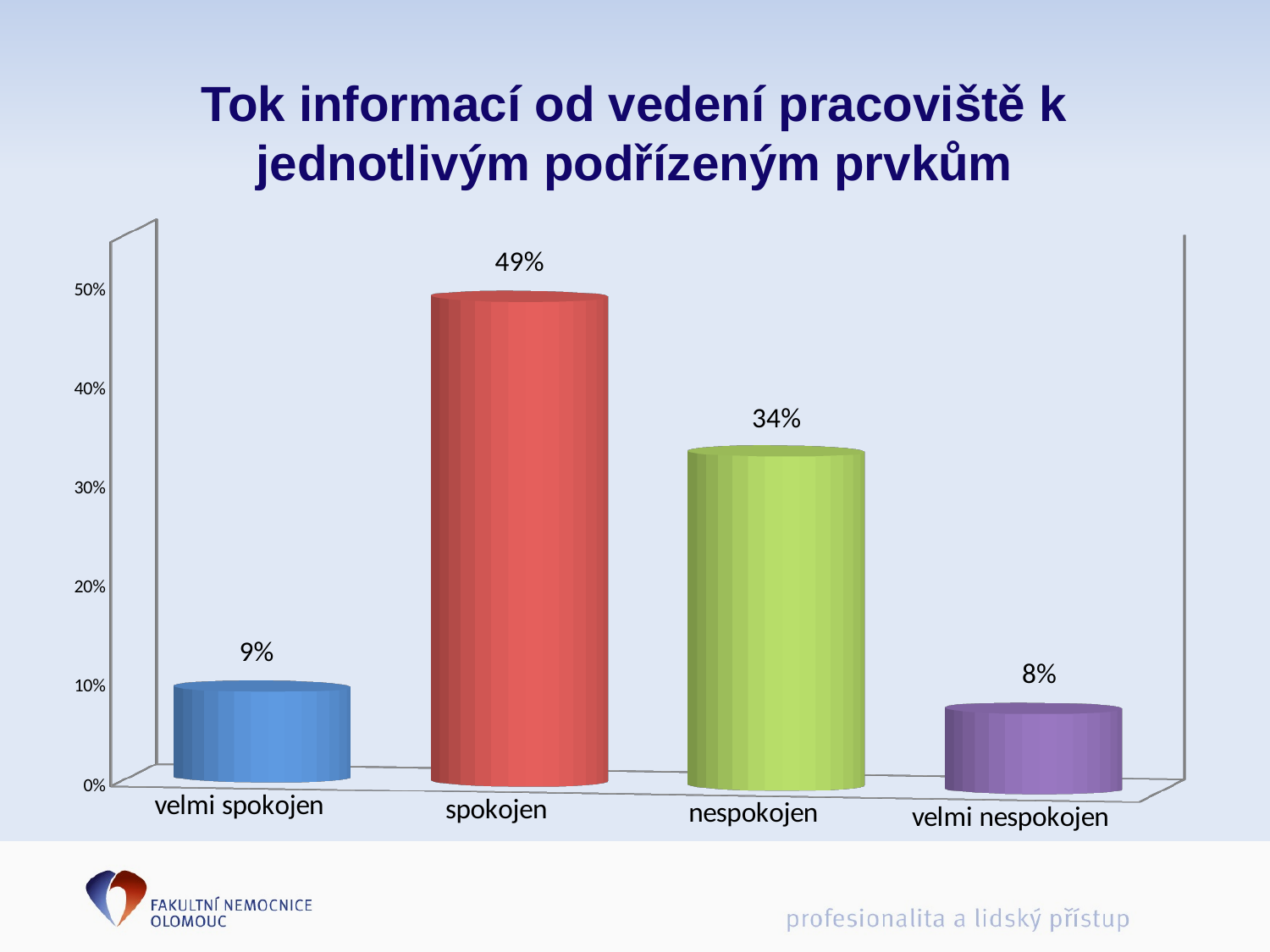
What colour is the bar for "spokojen"? red What kind of chart is shown on the slide? bar chart Is the value for "nespokojen" greater or less than 30%? greater What is the value for "velmi nespokojen"? 8% Which category has the lowest value? velmi nespokojen What is the title of the chart on the slide? Tok informací od vedení pracoviště k jednotlivým podřízeným prvkům What is the difference between the values for "spokojen" and "nespokojen"? 15% What is the value for "spokojen"? 49% Which is larger, the value for "velmi spokojen" or the value for "velmi nespokojen"? velmi spokojen Which category has the highest value? spokojen What is the value for "nespokojen"? 34% How many categories are shown on the x axis? 4